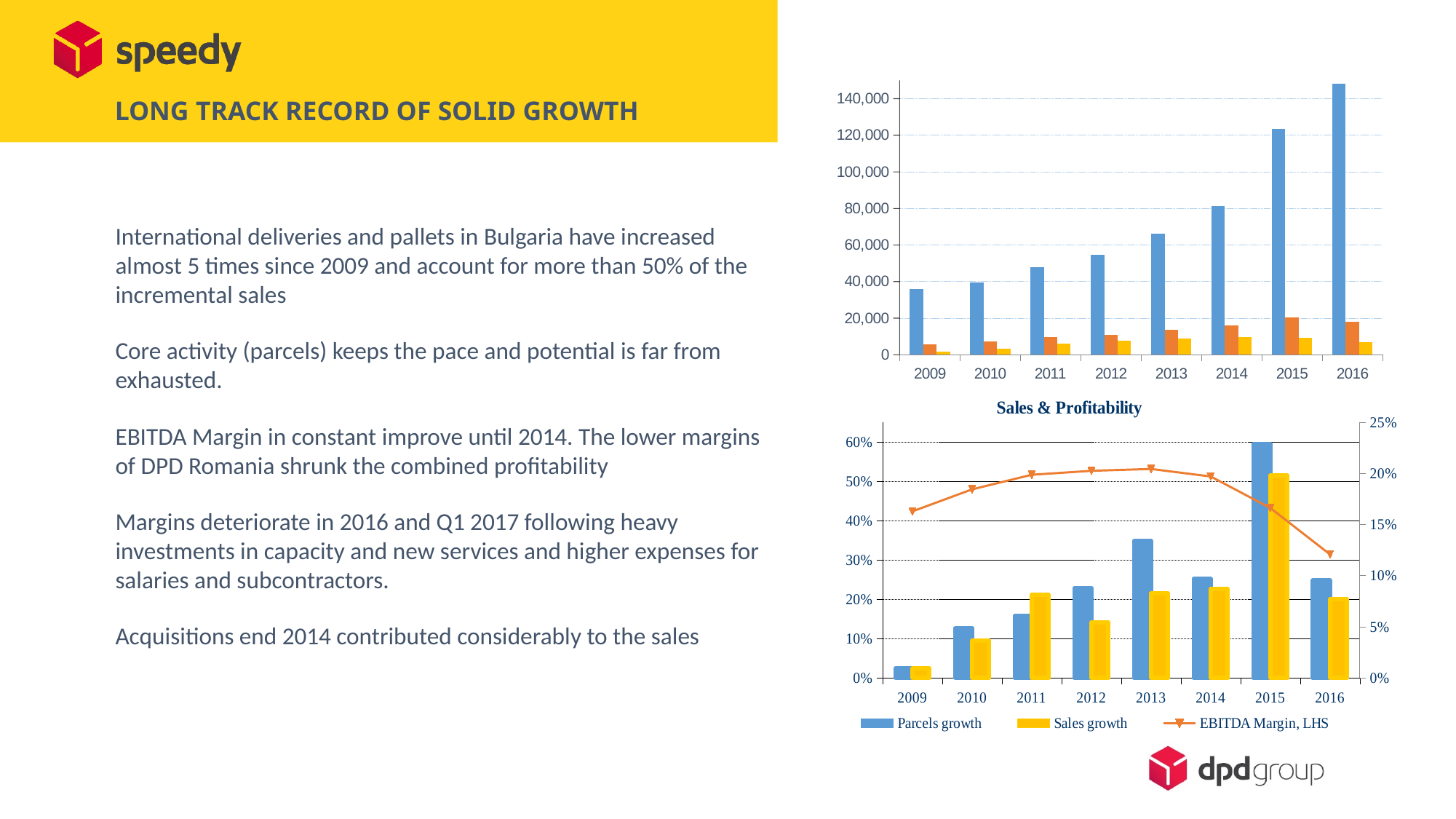
How many years are shown on the x axis of the top chart? 8 In the Sales & Profitability chart, does the EBITDA Margin line rise or fall from 2013 to 2016? fall In the Sales & Profitability chart, which is larger in 2012: Parcels growth or Sales growth? Parcels growth What is the title of the bottom chart? Sales & Profitability In the top chart, is the blue bar for 2009 greater or less than 40,000? less What kind of chart is the top chart on the slide? bar chart In the top chart, is the blue bar for 2016 greater or less than 140,000? greater In the top chart, which year has the tallest blue bar? 2016 How many series does the legend of the Sales & Profitability chart list? 3 In the top chart, do the blue bars rise or fall from 2009 to 2016? rise In the Sales & Profitability chart, is Parcels growth for 2015 greater or less than 50%? greater In the Sales & Profitability chart, which year has the highest Parcels growth? 2015